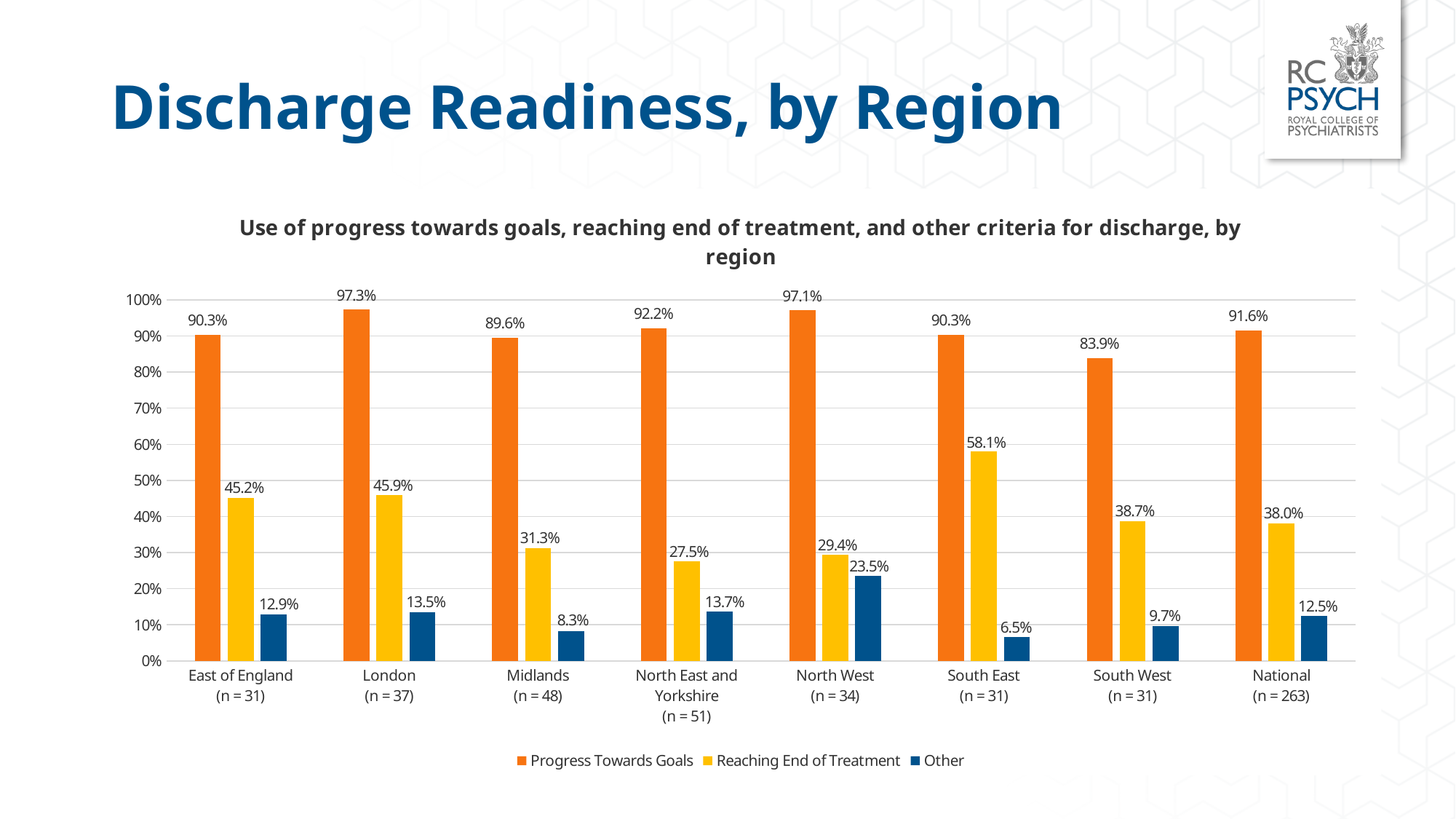
Which region has the lowest value for Progress Towards Goals? South West Which is larger: the Other value for Midlands or the Other value for North East and Yorkshire? North East and Yorkshire Which region has the highest value for Reaching End of Treatment? South East Which region has the lowest value for Other? South East What is the value for Reaching End of Treatment in South East? 58.1% What is the value for Other in North West? 23.5% What is the difference between the Progress Towards Goals values for London and South West? 13.4% How many series does the legend list? 3 What is the National value for Reaching End of Treatment? 38.0% What kind of chart is shown on the slide? Bar chart How many regions (categories) are shown on the x axis? 8 What is the value for Progress Towards Goals in London? 97.3%